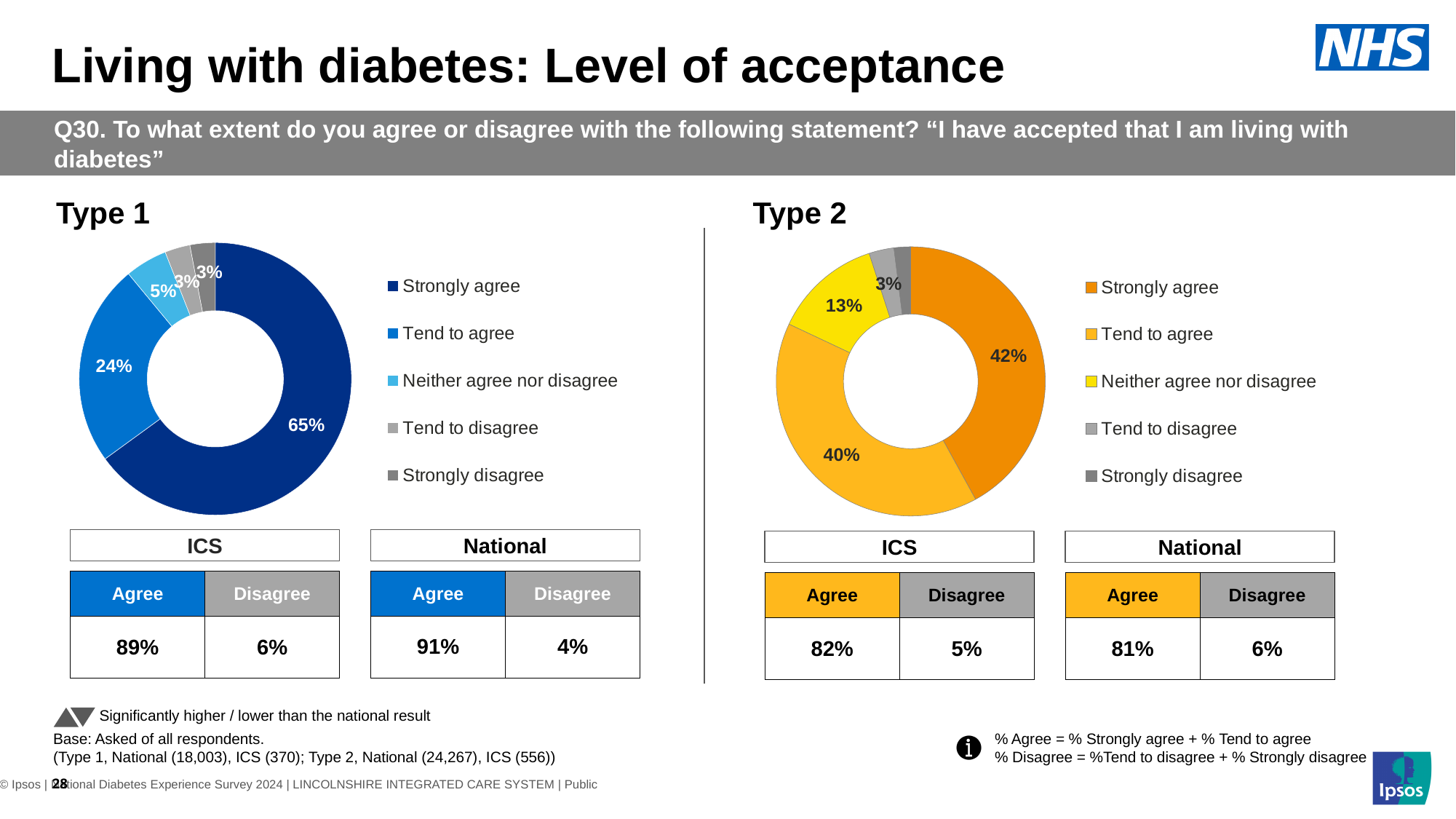
In the Type 1 chart, what percentage is shown for Neither agree nor disagree? 5% In the Type 1 chart, which category has the largest share? Strongly agree In the Type 2 chart, what is the difference in percentage points between Strongly agree and Neither agree nor disagree? 29 percentage points In the Type 2 chart, what percentage is shown for Neither agree nor disagree? 13% In the Type 1 chart, what percentage is shown for Strongly agree? 65% In the Type 1 chart, what percentage is shown for Tend to agree? 24% In the Type 2 chart, which is larger, Strongly agree or Tend to agree? Strongly agree How many entries does the legend of the Type 2 chart list? 5 In the Type 1 chart, what is the difference in percentage points between Strongly agree and Tend to agree? 41 percentage points In the Type 2 chart, what percentage is shown for Tend to agree? 40% In the Type 2 chart, what percentage is shown for Strongly agree? 42% What kind of chart is the Type 1 chart? doughnut chart